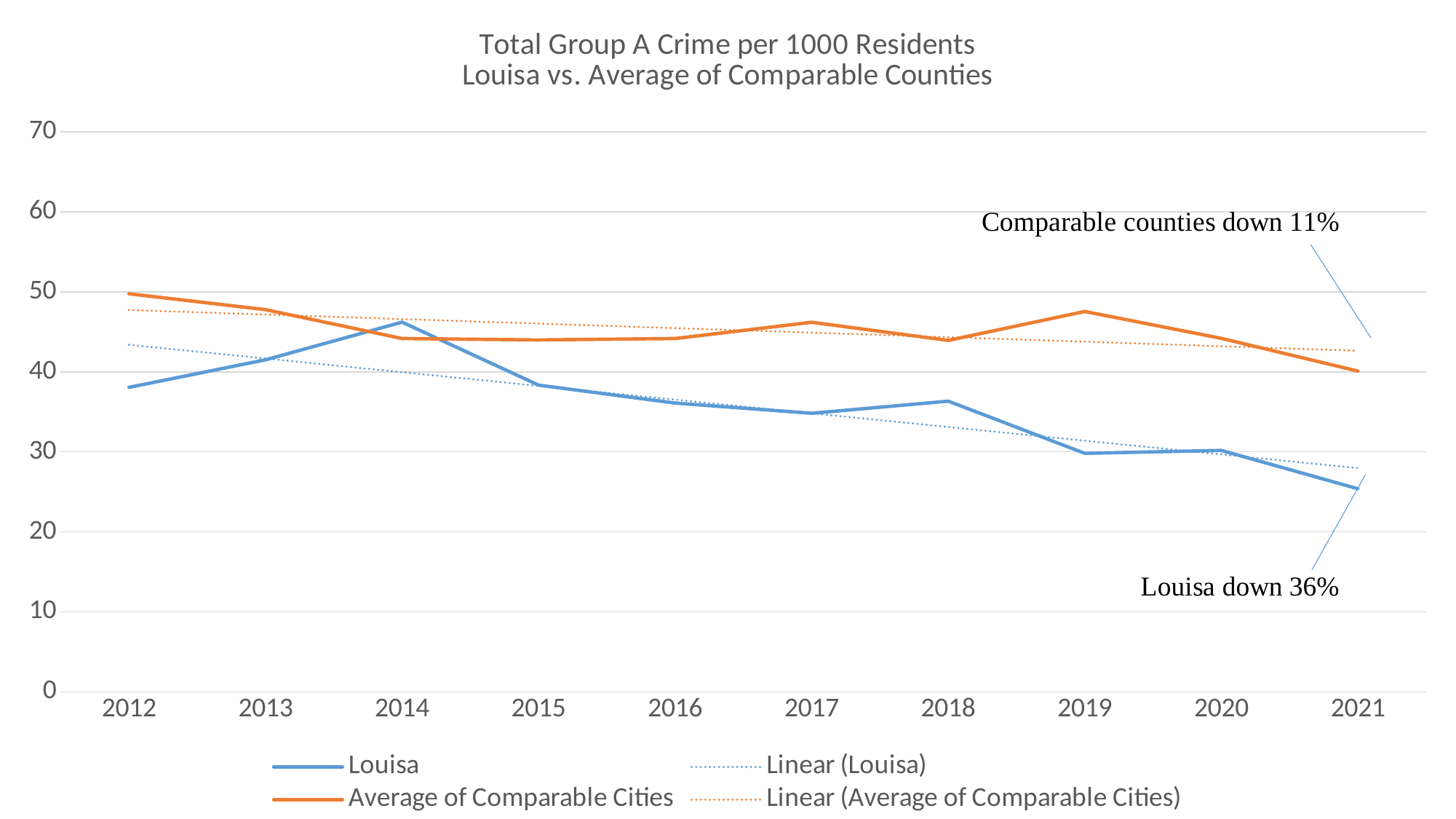
Is the Average of Comparable Cities value for 2019 greater or less than 40? greater How many years are plotted along the x axis? 10 In 2012, which is larger: the Louisa value or the Average of Comparable Cities value? Average of Comparable Cities In which year is the Average of Comparable Cities value highest? 2012 How many series does the legend list? 4 What kind of chart is shown on the slide? Line chart Does the Louisa line generally rise or fall from 2012 to 2021? Fall According to the annotation on the chart, by what percentage is Louisa down? 36% In which year is the Louisa value highest? 2014 In which year is the Louisa value lowest? 2021 Is the Louisa value for 2021 greater or less than 30? less In which year is the Average of Comparable Cities value lowest? 2021